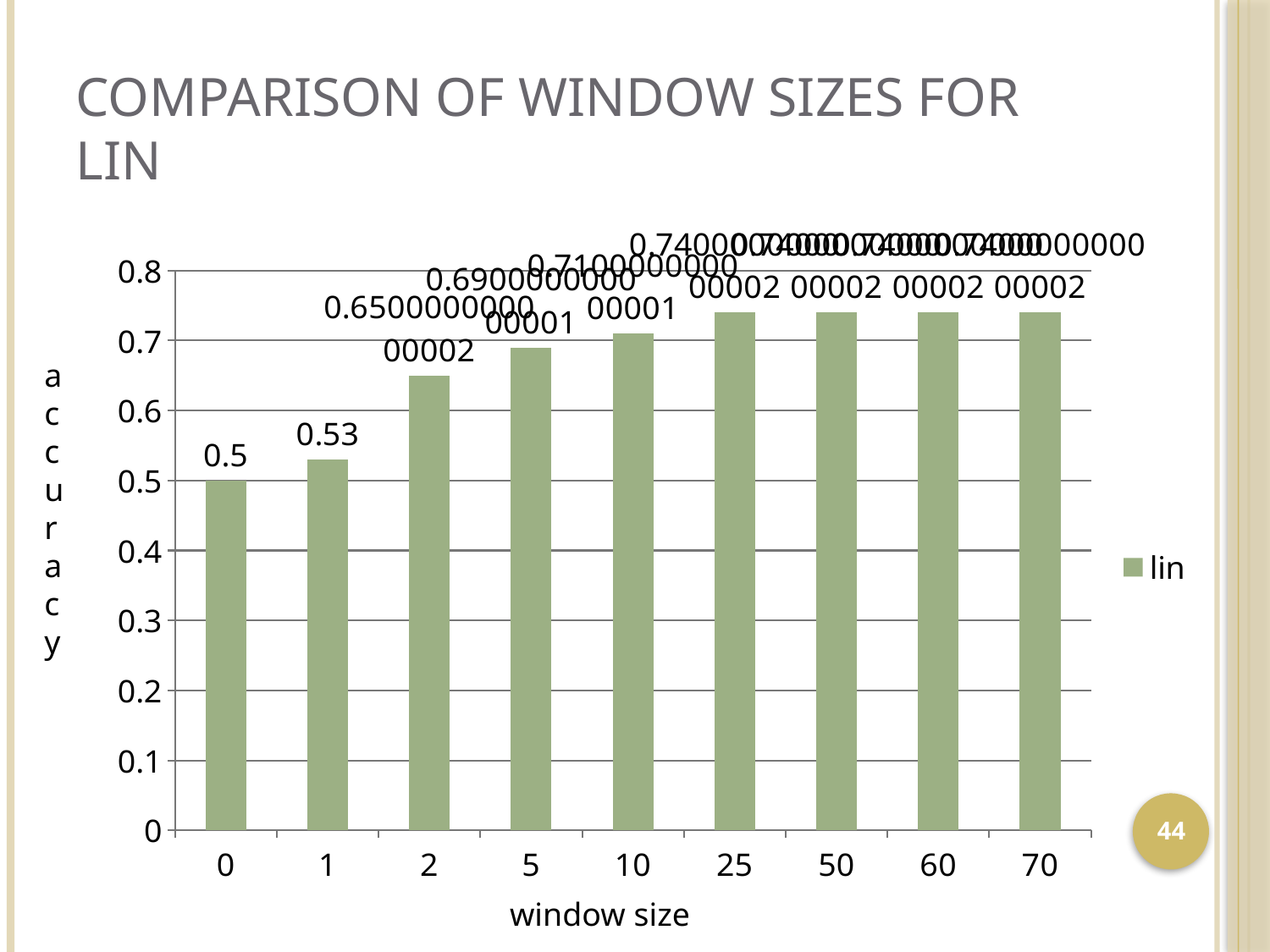
Is the accuracy for window size 50 greater or less than 0.7? greater What is the difference in accuracy between window size 1 and window size 0? 0.03 What is the accuracy value for window size 0? 0.5 Which window size has the lowest accuracy? 0 What kind of chart is shown on the slide? bar chart How many series does the legend list? 1 Is the accuracy for window size 2 greater or less than 0.6? greater Which has the higher accuracy, window size 0 or window size 1? window size 1 How many window sizes are shown on the x axis? 9 Do the accuracy values generally rise or fall as window size increases from 0 to 25? rise What is the accuracy value for window size 1? 0.53 Is the accuracy for window size 5 greater or less than 0.7? less